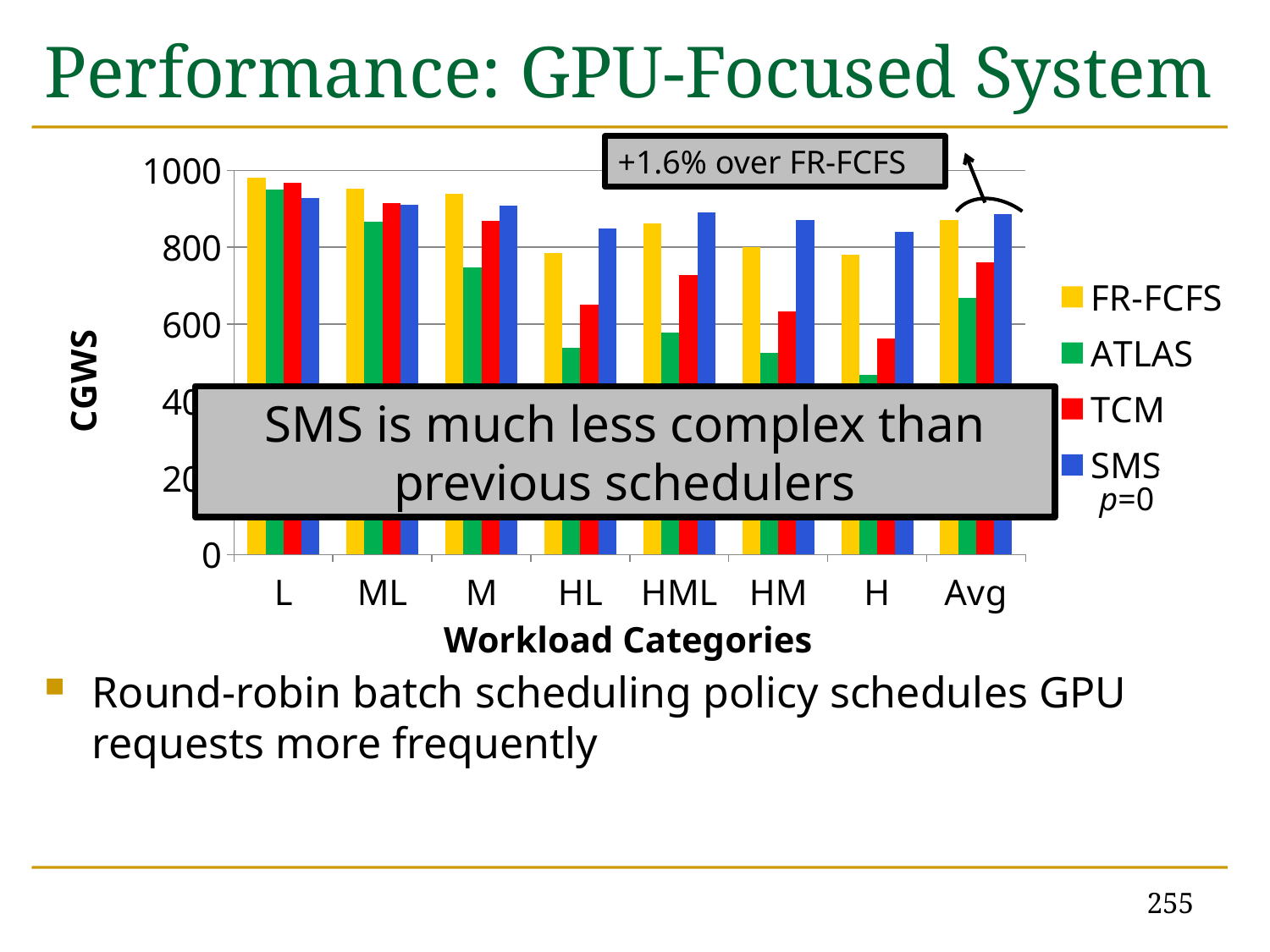
Which scheduler has the lowest value for the HM workload category? ATLAS What is the label on the x axis? Workload Categories For the HL workload category, which is larger, the ATLAS value or the TCM value? TCM How many workload categories are shown on the x axis? 8 What kind of chart is shown on the slide? bar chart How many series does the legend list? 4 Is the ATLAS value for HL greater or less than 600? less Is the FR-FCFS value for L greater or less than 800? greater Is the SMS value for HML greater or less than 800? greater Which scheduler has the highest value for the HL workload category? SMS What is the label on the y axis? CGWS